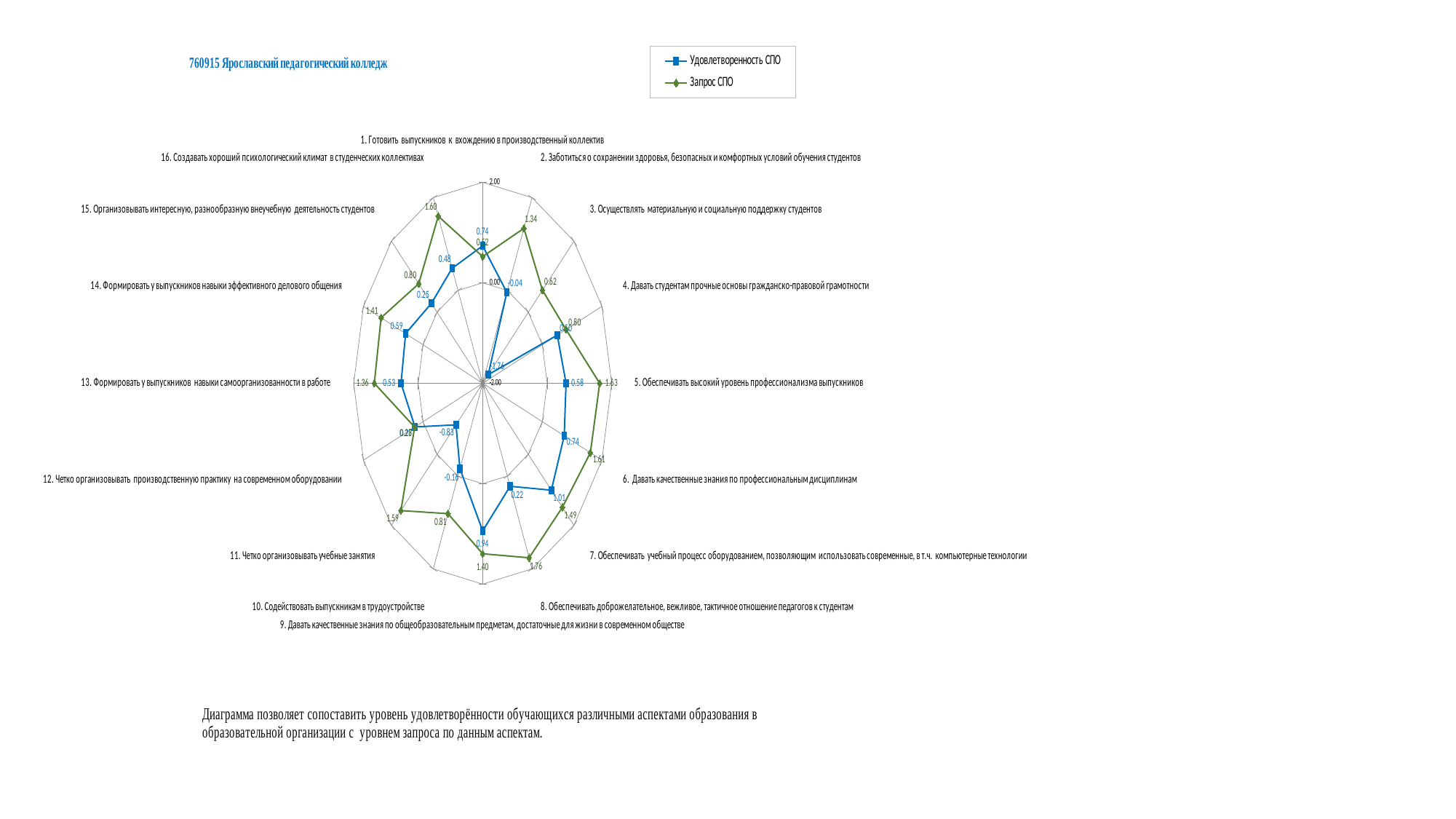
What are the two series named in the legend? Удовлетворенность СПО and Запрос СПО What is the value of Удовлетворенность СПО for category 7 (Обеспечивать учебный процесс оборудованием...)? 1.01 What kind of chart is shown on the slide? Radar chart How many categories (axes) does the radar chart have? 16 What is the difference between Запрос СПО and Удовлетворенность СПО for category 5 (Обеспечивать высокий уровень профессионализма выпускников)? 1.05 Which category has the highest Запрос СПО value? 8. Обеспечивать доброжелательное, вежливое, тактичное отношение педагогов к студентам What is the value of Запрос СПО for category 5 (Обеспечивать высокий уровень профессионализма выпускников)? 1.63 Which category has the lowest Удовлетворенность СПО value? 3. Осуществлять материальную и социальную поддержку студентов For category 6 (Давать качественные знания по профессиональным дисциплинам), which series has the larger value, Запрос СПО or Удовлетворенность СПО? Запрос СПО What is the value of Запрос СПО for category 8 (Обеспечивать доброжелательное, вежливое, тактичное отношение педагогов к студентам)? 1.76 What is the value of Удовлетворенность СПО for category 13 (Формировать у выпускников навыки самоорганизованности в работе)? 0.53 How many series does the legend list? 2